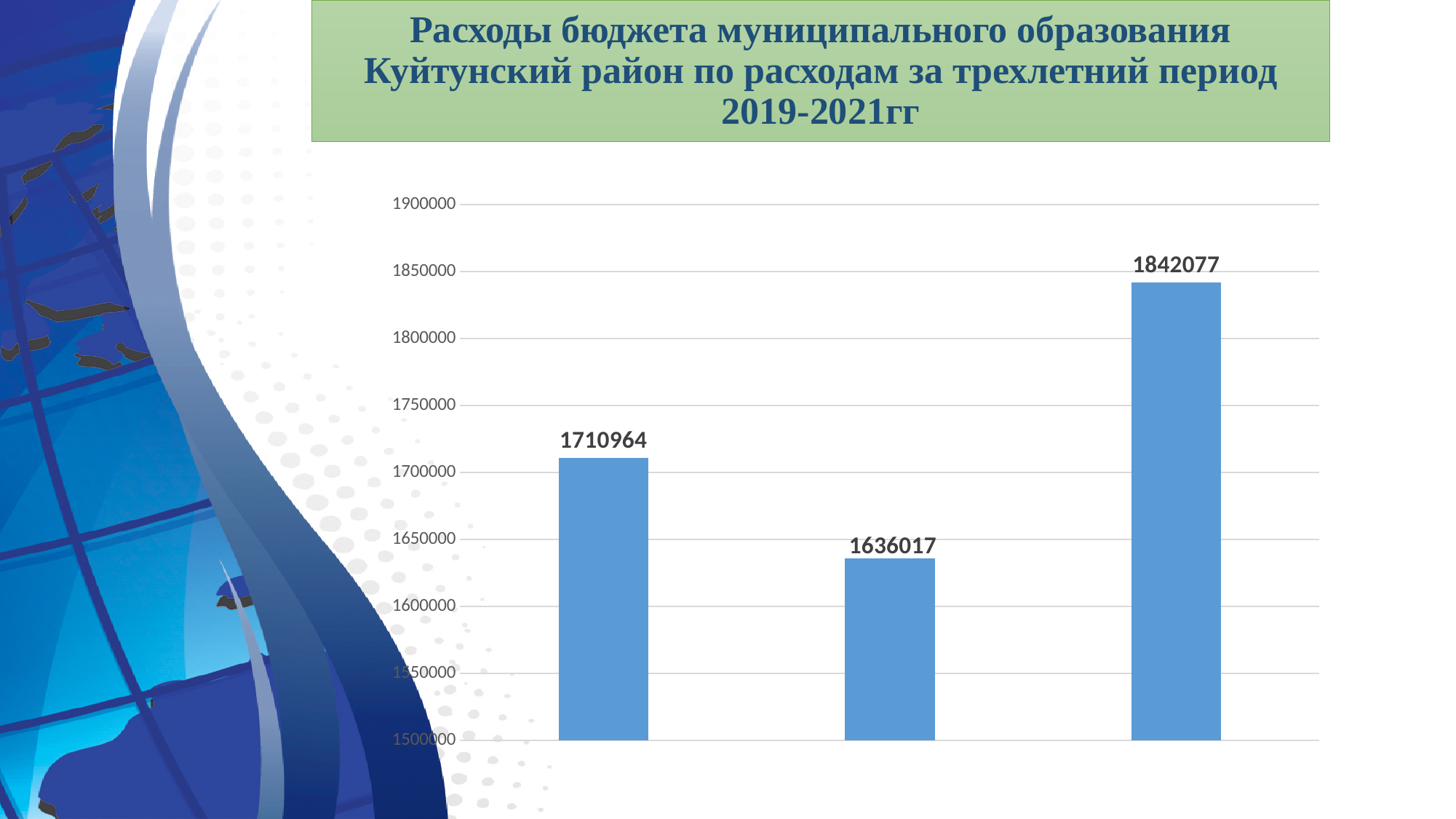
What type of chart is shown on the slide? bar chart How many bars are plotted in the chart? 3 Is the value of the middle bar greater or less than 1650000? less What is the value shown on the rightmost bar? 1842077 What is the difference between the rightmost bar's value and the leftmost bar's value? 131113 What is the difference between the leftmost bar's value and the middle bar's value? 74947 Is the value of the rightmost bar greater or less than 1800000? greater Which bar has the highest value: the leftmost, middle or rightmost? rightmost What is the value shown on the middle bar? 1636017 Which is larger, the leftmost bar or the middle bar? leftmost bar What is the value shown on the leftmost bar? 1710964 Which bar has the lowest value: the leftmost, middle or rightmost? middle